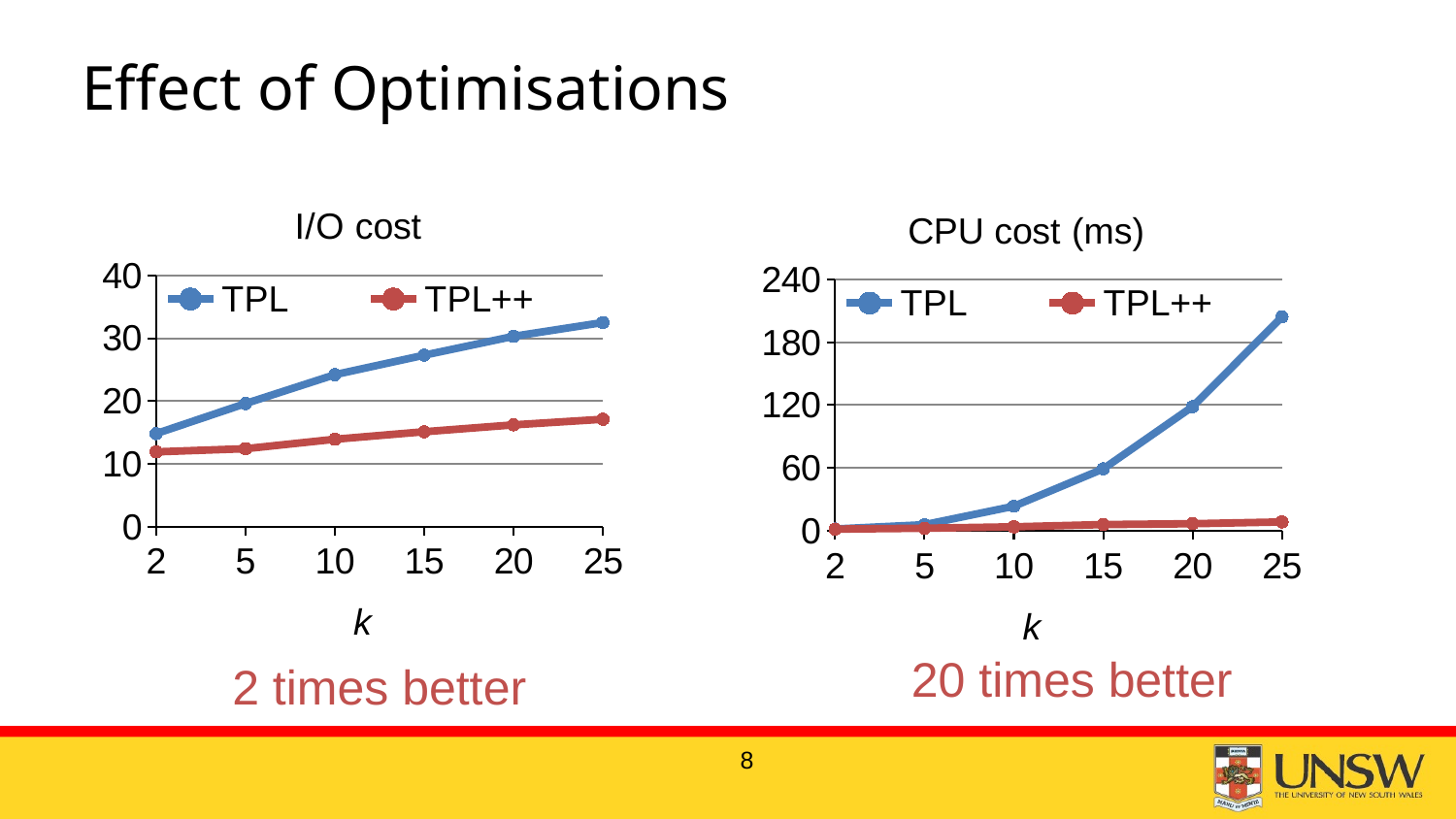
In the I/O cost chart, is the value for TPL++ at k = 25 greater or less than 20? less In the I/O cost chart, which series has the higher value at k = 25, TPL or TPL++? TPL How many values of k are plotted on the x axis of the I/O cost chart? 6 What kind of chart is the I/O cost chart? line chart In the CPU cost (ms) chart, does the TPL series rise or fall as k increases? rise In the CPU cost (ms) chart, is the value for TPL at k = 10 greater or less than 60? less What is the x-axis label of the CPU cost (ms) chart? k In the CPU cost (ms) chart, is the value for TPL at k = 25 greater or less than 180? greater In the I/O cost chart, does the TPL series rise or fall as k increases? rise In the CPU cost (ms) chart, which series has the lower value at k = 25, TPL or TPL++? TPL++ How many series does the legend of the CPU cost (ms) chart list? 2